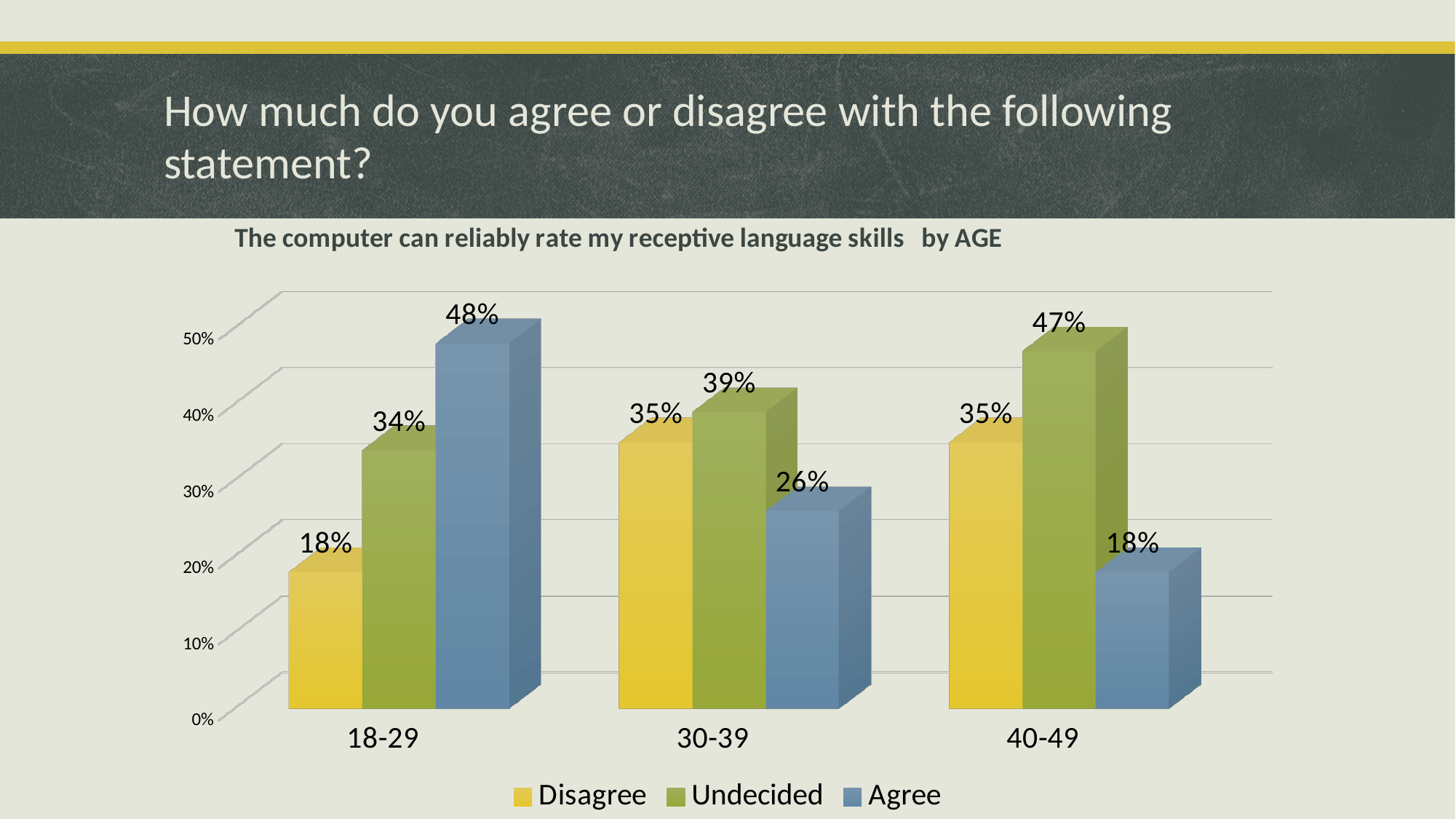
What is the Undecided value for the 40-49 age group? 47% Which age group has the lowest Disagree value? 18-29 How many age groups are shown on the x axis? 3 What percentage of the 18-29 age group agree with the statement? 48% Does the Agree value rise or fall from the 18-29 group to the 40-49 group? Fall Which is larger for the 30-39 age group: Undecided or Agree? Undecided What is the difference between the Agree values for the 18-29 and 40-49 age groups? 30% How many series does the legend list? 3 What colour represents the Undecided series in the legend? Green What kind of chart is shown on the slide? Bar chart Which age group has the highest Agree value? 18-29 What percentage of the 30-39 age group disagree? 35%